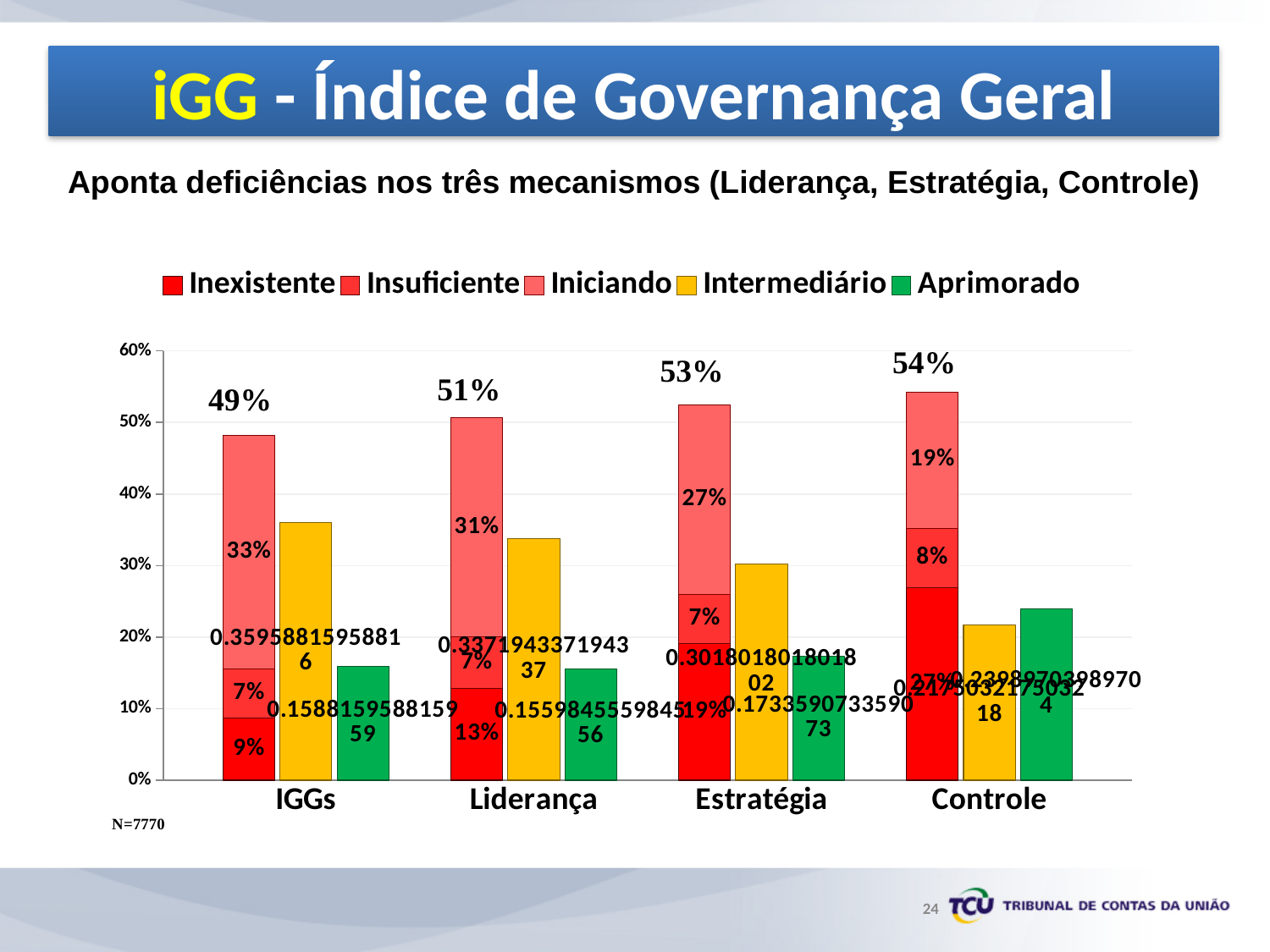
How many series does the legend list? 5 What is the Iniciando value for IGGs? 33% Which has the larger Inexistente value, Liderança or Estratégia? Estratégia How many categories are shown on the x axis? 4 What is the Inexistente value for Controle? 27% Do the stacked-bar totals rise or fall from IGGs to Controle along the x axis? rise What is the difference between the stacked-bar totals for Controle and IGGs? 5 percentage points Which category has the highest stacked-bar total? Controle What kind of chart is shown on the slide? bar chart Which category has the lowest stacked-bar total? IGGs What is the total printed above the stacked bar for Estratégia? 53% Is the Intermediário value for IGGs greater or less than 30%? greater